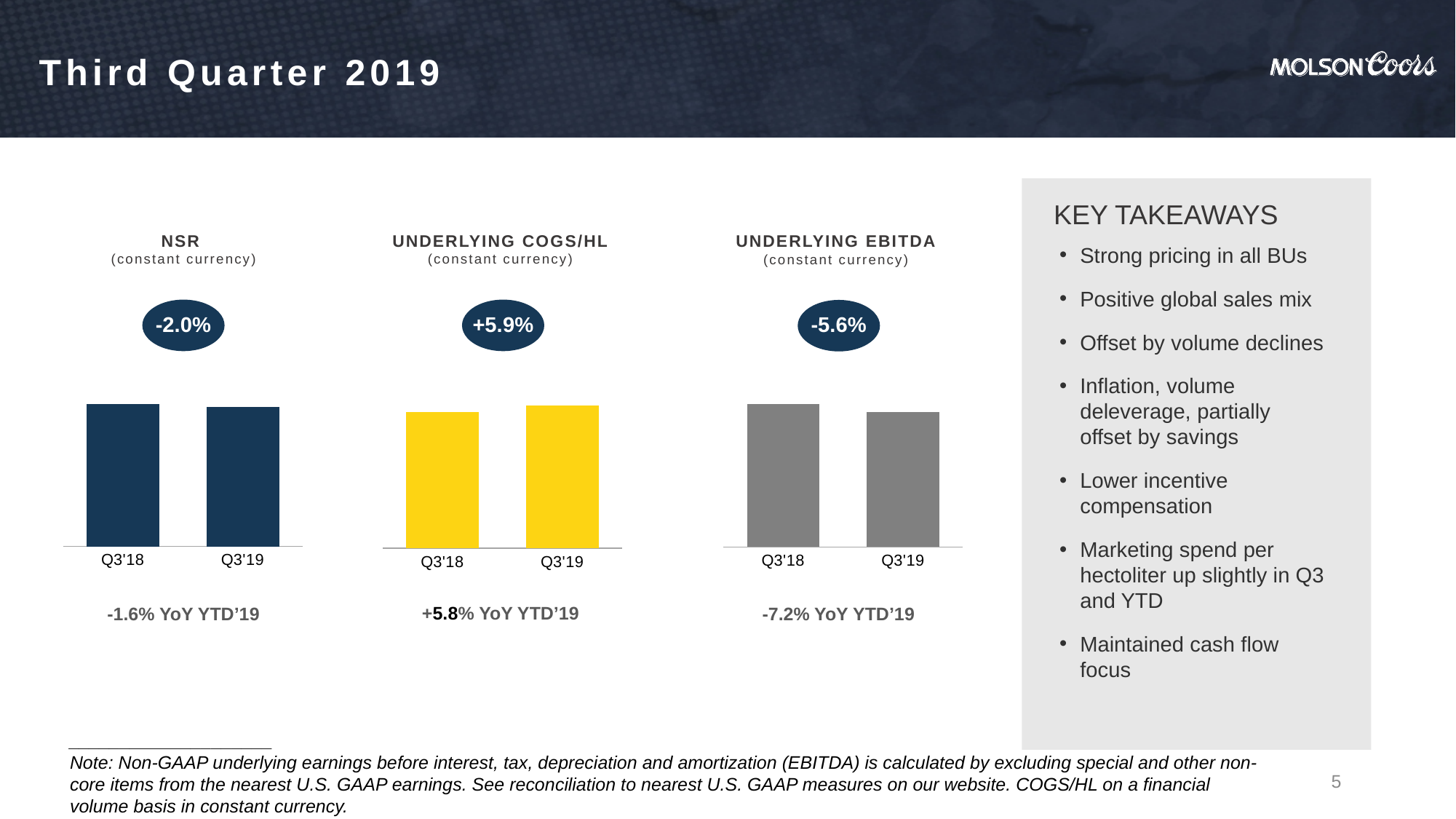
In the UNDERLYING COGS/HL (constant currency) chart, do the bars rise or fall from Q3'18 to Q3'19? rise In the UNDERLYING EBITDA (constant currency) chart, do the bars rise or fall from Q3'18 to Q3'19? fall What kind of chart is the NSR (constant currency) chart? bar chart What are the two category labels on the x axis of the NSR (constant currency) chart? Q3'18 and Q3'19 What percentage change is shown above the UNDERLYING COGS/HL (constant currency) chart? +5.9% In the NSR (constant currency) chart, which bar is taller, Q3'18 or Q3'19? Q3'18 In the UNDERLYING EBITDA (constant currency) chart, which bar is shorter, Q3'18 or Q3'19? Q3'19 What percentage change is shown above the NSR (constant currency) chart? -2.0% In the UNDERLYING COGS/HL (constant currency) chart, which bar is taller, Q3'18 or Q3'19? Q3'19 How many bars are plotted in the UNDERLYING EBITDA (constant currency) chart? 2 What percentage change is shown above the UNDERLYING EBITDA (constant currency) chart? -5.6% What colour are the bars in the UNDERLYING COGS/HL (constant currency) chart? yellow